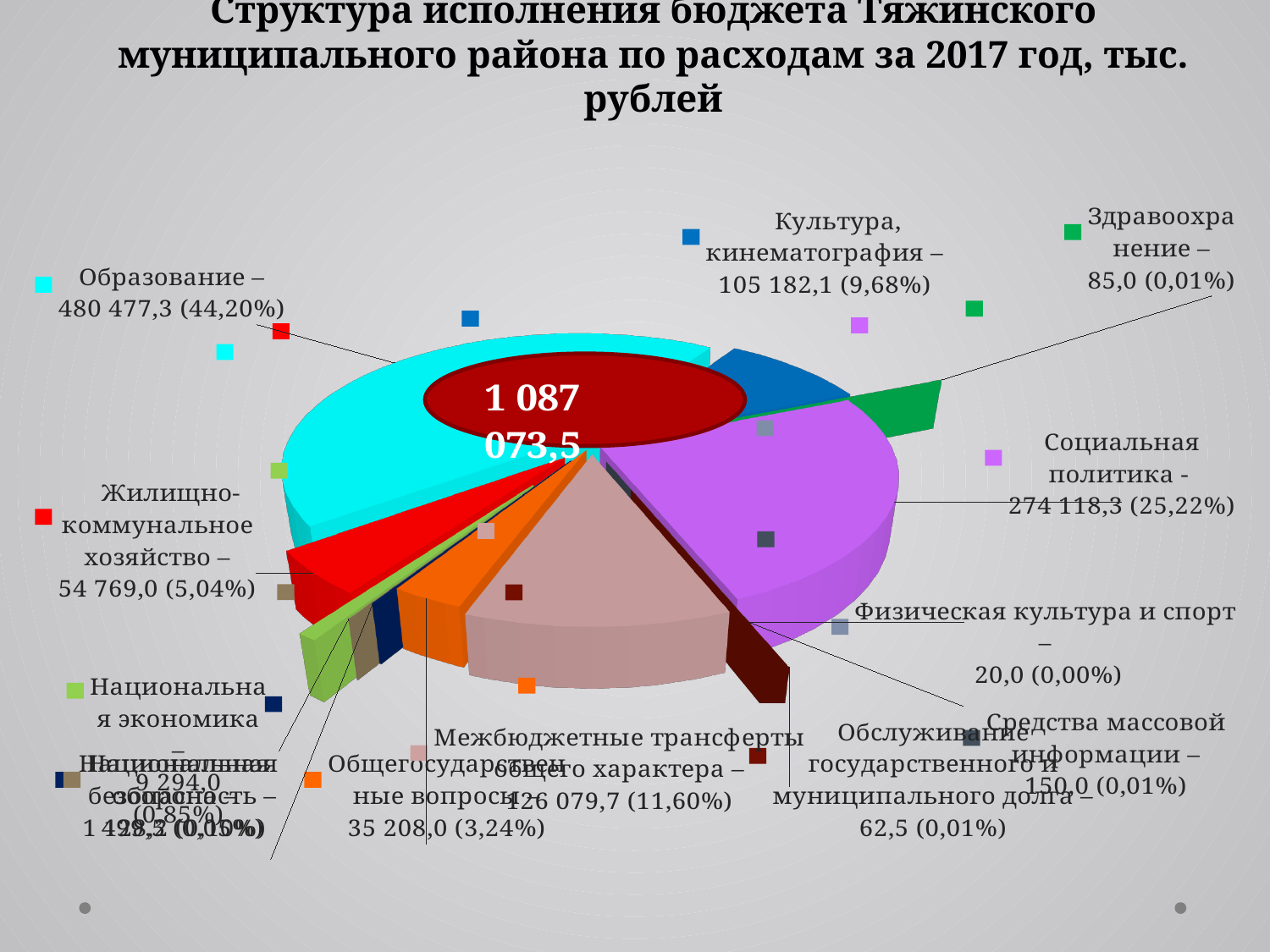
What kind of chart is shown on the slide? pie chart Which category has the smallest value in the chart? Физическая культура и спорт What value is shown for Жилищно-коммунальное хозяйство? 54 769,0 What value is shown for Образование? 480 477,3 Which category has the largest slice of the pie? Образование What value is shown for Культура, кинематография? 105 182,1 Which is larger, Социальная политика or Культура, кинематография? Социальная политика What is the difference between the values for Образование and Социальная политика? 206 359,0 What share of the pie does Межбюджетные трансферты общего характера represent? 11,60% What share of the pie does Социальная политика represent? 25,22% What total value is printed in the centre of the pie chart? 1 087 073,5 What share of the pie does Общегосударственные вопросы represent? 3,24%